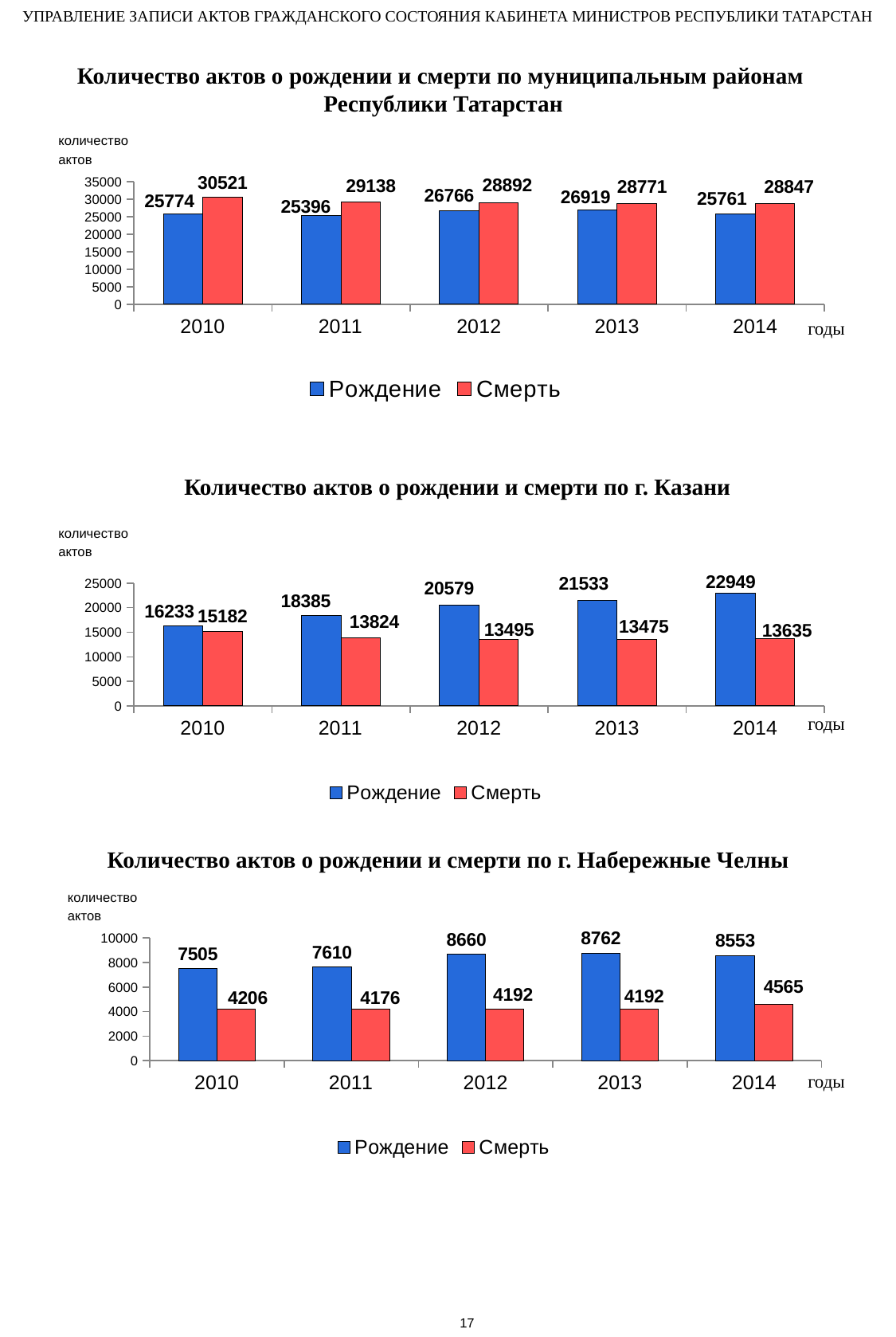
In the chart 'Количество актов о рождении и смерти по г. Набережные Челны', which year has the highest value for Рождение? 2013 In the chart 'Количество актов о рождении и смерти по муниципальным районам Республики Татарстан', which year has the highest value for Рождение? 2013 How many years are shown on the x axis of the chart 'Количество актов о рождении и смерти по г. Набережные Челны'? 5 In the chart 'Количество актов о рождении и смерти по муниципальным районам Республики Татарстан', what is the difference between Смерть and Рождение in 2014? 3086 In the chart 'Количество актов о рождении и смерти по г. Набережные Челны', what is the value for Смерть in 2014? 4565 In the chart 'Количество актов о рождении и смерти по г. Казани', what is the value for Рождение in 2014? 22949 In the chart 'Количество актов о рождении и смерти по г. Казани', which is larger in 2010: Рождение or Смерть? Рождение How many series does the legend of the chart 'Количество актов о рождении и смерти по г. Казани' list? 2 In the chart 'Количество актов о рождении и смерти по г. Казани', which year has the lowest value for Смерть? 2013 In the chart 'Количество актов о рождении и смерти по г. Набережные Челны', what is the difference between Рождение and Смерть in 2012? 4468 In the chart 'Количество актов о рождении и смерти по г. Казани', does the Рождение series rise or fall from 2010 to 2014? rise In the chart 'Количество актов о рождении и смерти по муниципальным районам Республики Татарстан', what is the value for Смерть in 2010? 30521